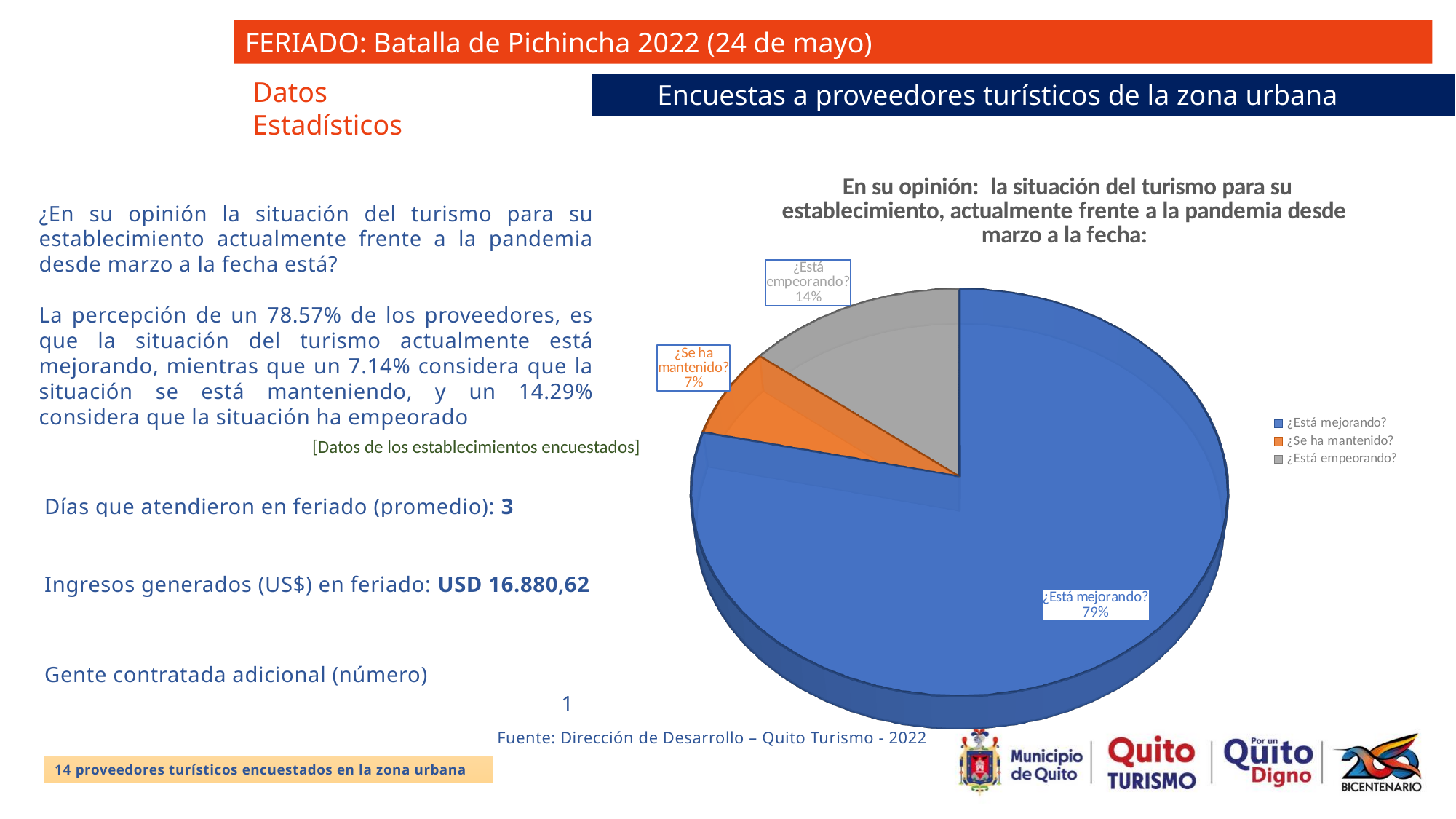
What share of the pie does '¿Está mejorando?' represent? 79% What is the difference in percentage points between '¿Está empeorando?' and '¿Se ha mantenido?'? 7% What share of the pie does '¿Está empeorando?' represent? 14% What colour is the '¿Está mejorando?' slice in the pie chart? blue What share of the pie does '¿Se ha mantenido?' represent? 7% Which is larger, the share for '¿Está empeorando?' or the share for '¿Se ha mantenido?'? ¿Está empeorando? What is the difference in percentage points between '¿Está mejorando?' and '¿Está empeorando?'? 65% Which category has the smallest slice of the pie? ¿Se ha mantenido? Which category has the largest slice of the pie? ¿Está mejorando? What kind of chart is shown on the slide? pie chart How many entries does the chart legend list? 3 How many categories does the pie chart show? 3